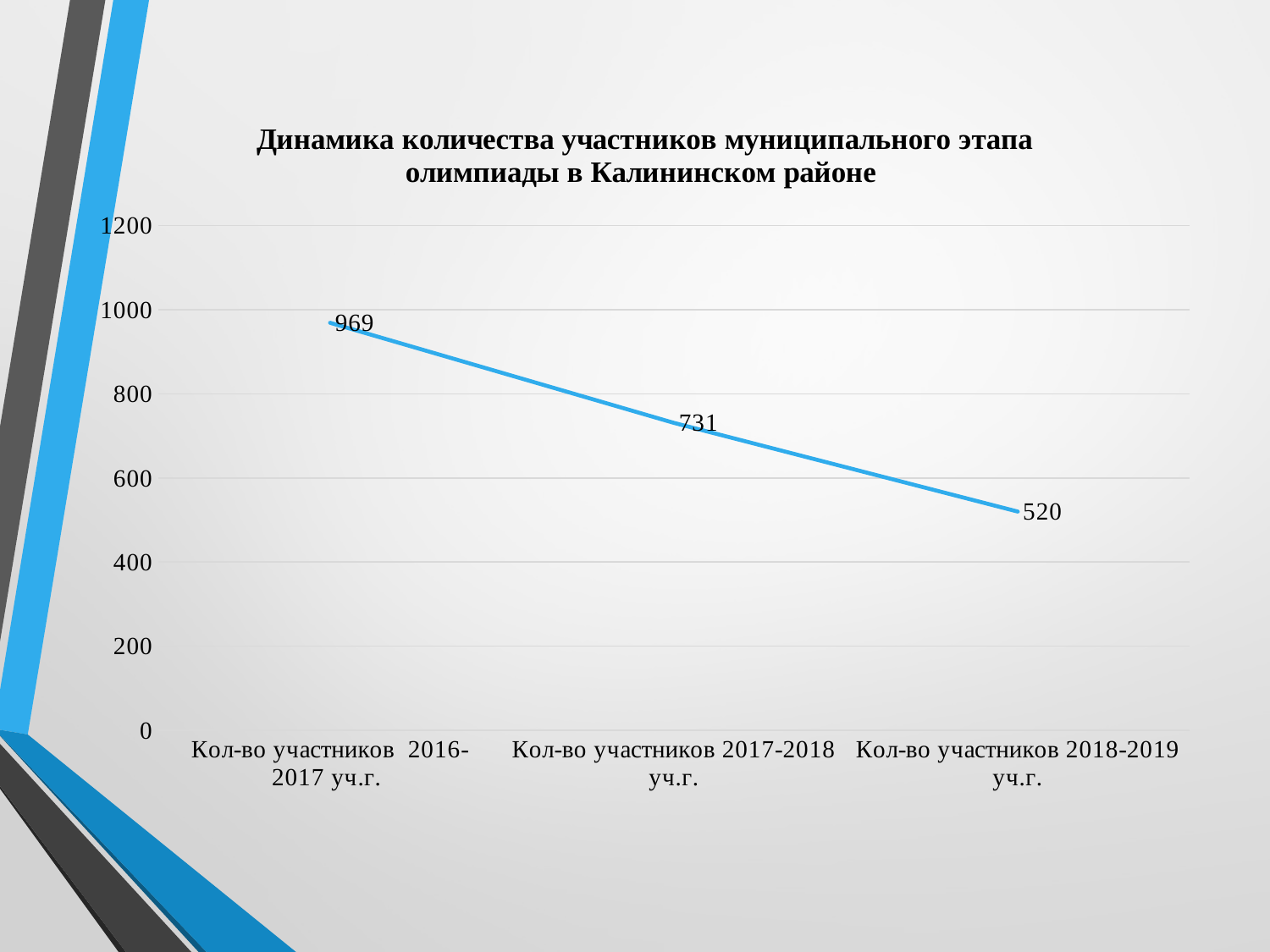
What is the difference between the number of participants in 2016-2017 and 2017-2018? 238 Which is larger: the number of participants in 2017-2018 or in 2018-2019? 2017-2018 What is the number of participants for 2018-2019 уч.г.? 520 What kind of chart is shown on the slide? line chart Is the value for 2017-2018 уч.г. greater or less than 800? less What is the difference between the number of participants in 2016-2017 and 2018-2019? 449 What is the number of participants for 2016-2017 уч.г.? 969 What is the number of participants for 2017-2018 уч.г.? 731 Which academic year has the highest number of participants? 2016-2017 уч.г. Which academic year has the lowest number of participants? 2018-2019 уч.г. Do the values rise or fall from 2016-2017 to 2018-2019? fall How many data points are plotted on the chart? 3